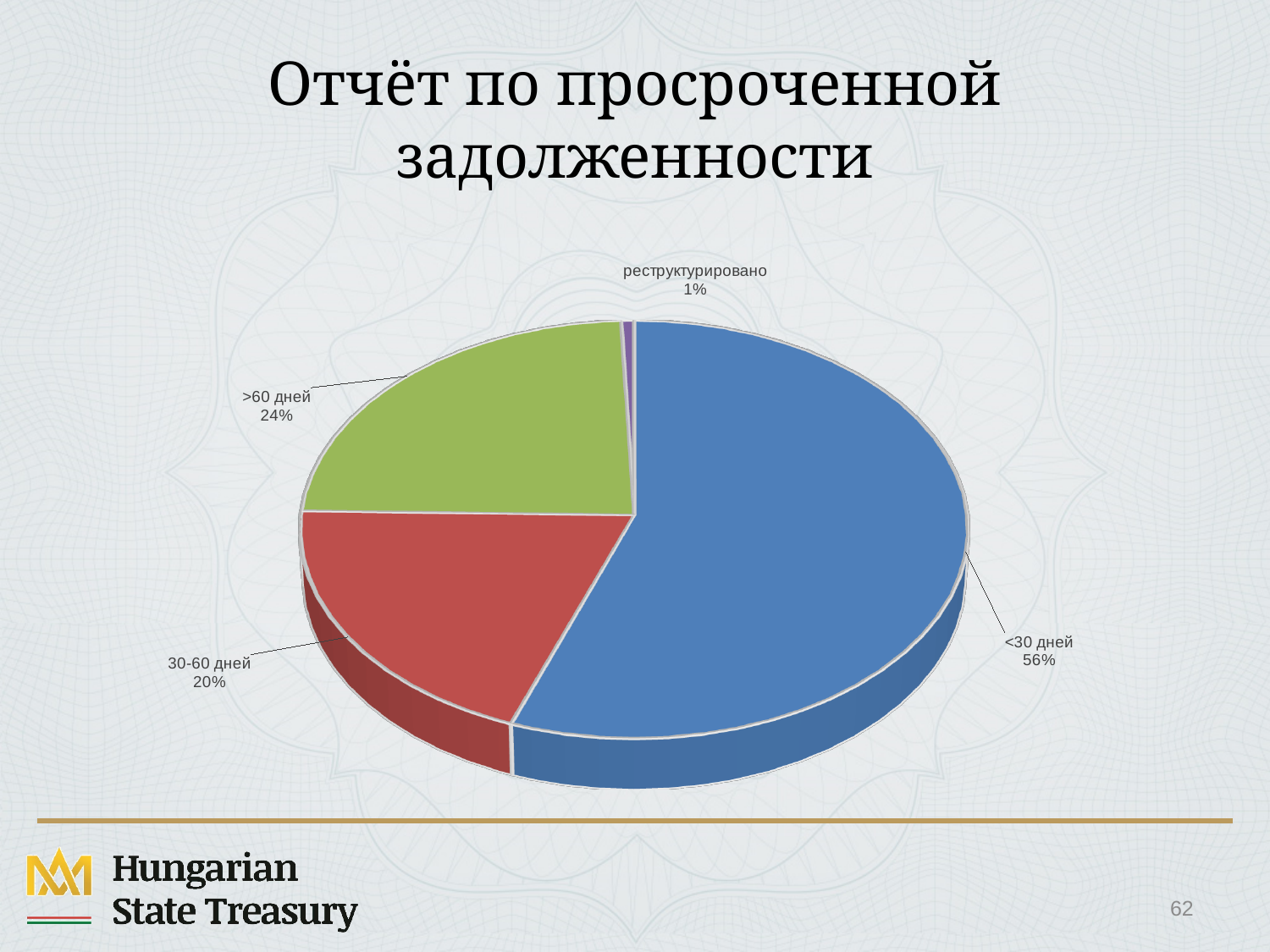
What is the difference in percentage points between the ">60 дней" and "30-60 дней" slices? 4 What share of the pie does the "<30 дней" slice represent? 56% How many slices does the pie chart have? 4 Which slice is larger, ">60 дней" or "30-60 дней"? >60 дней What kind of chart is shown on the slide? pie chart What is the title of the slide containing the chart? Отчёт по просроченной задолженности What share of the pie does the "реструктурировано" slice represent? 1% What is the difference in percentage points between the "<30 дней" and ">60 дней" slices? 32 Which category has the largest share of the pie? <30 дней What share of the pie does the "30-60 дней" slice represent? 20% Which category has the smallest share of the pie? реструктурировано